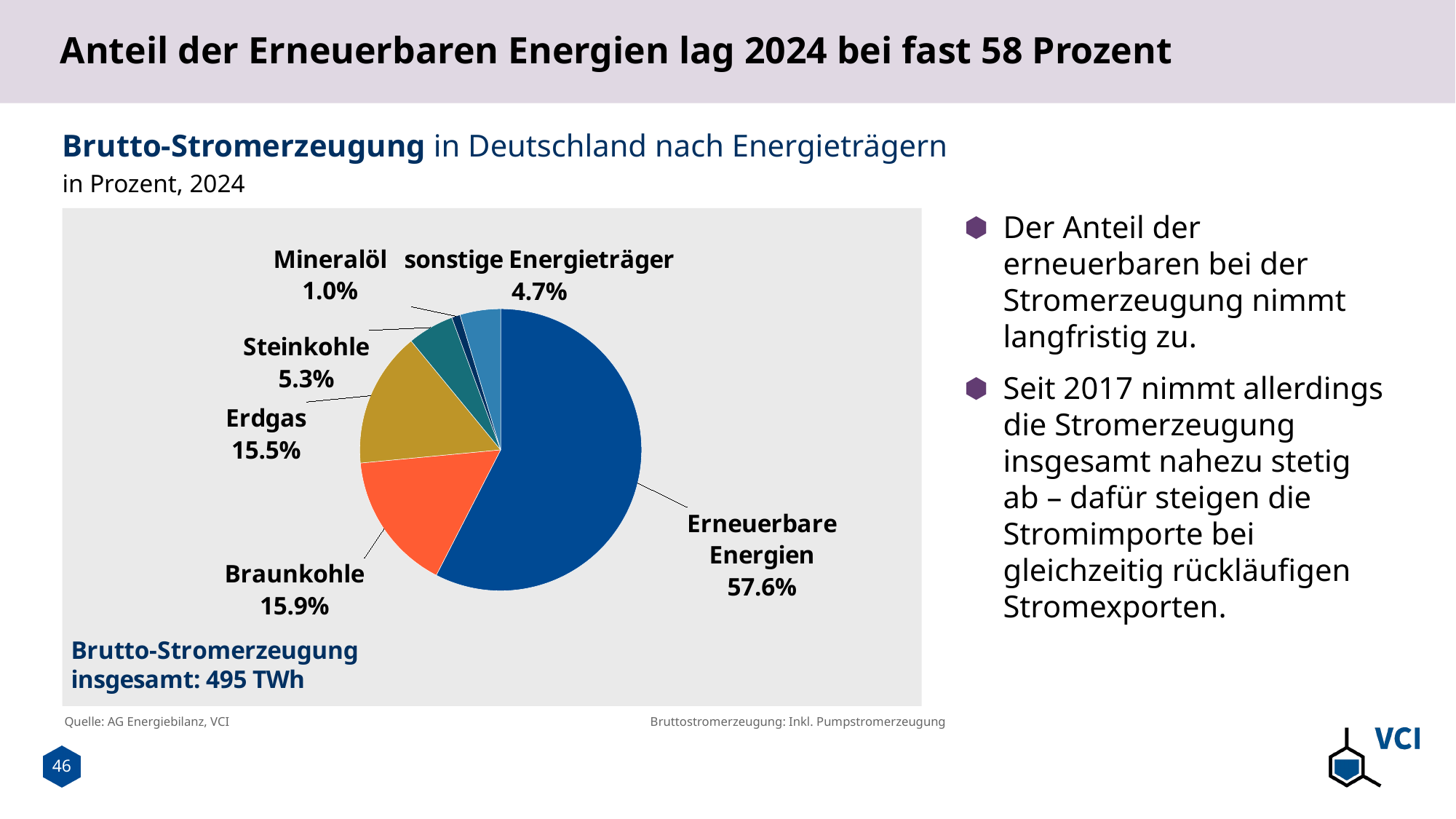
What total gross electricity generation is stated below the chart? 495 TWh Which is larger, the share of Steinkohle or the share of sonstige Energieträger? Steinkohle What is the value shown for Braunkohle? 15.9% Which energy source has the largest slice of the pie? Erneuerbare Energien What is the value shown for Steinkohle? 5.3% What kind of chart is shown on the slide? Pie chart What share of gross electricity generation does Erneuerbare Energien account for? 57.6% What is the difference between the shares of Braunkohle and Erdgas? 0.4% How many energy source categories are shown in the pie chart? 6 Which energy source has the smallest slice of the pie? Mineralöl What is the value shown for Erdgas? 15.5% What is the value shown for sonstige Energieträger? 4.7%